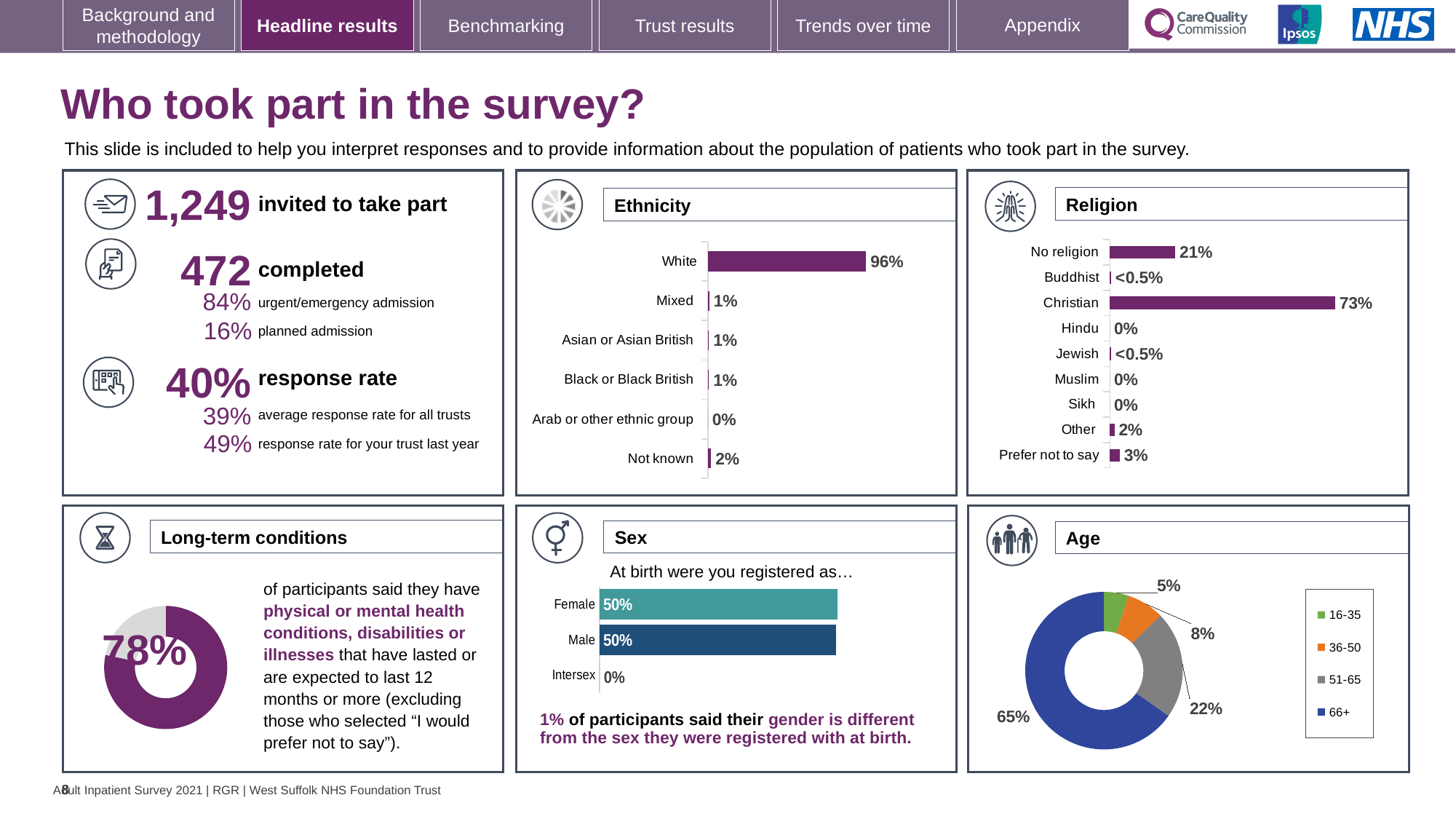
In the Age chart, how many age groups does the legend list? 4 In the Religion chart, what is the difference between the Christian and No religion values? 52% What kind of chart is used for the Age breakdown? Donut chart In the Religion chart, what percentage of participants were Christian? 73% In the Ethnicity chart, what is the value for Not known? 2% In the Ethnicity chart, what percentage of participants were White? 96% In the Ethnicity chart, how many ethnic group categories are shown? 6 In the Ethnicity chart, which ethnic group has the highest value? White In the Sex chart, what percentage of participants were registered as Female at birth? 50% In the Age chart, what share of participants were aged 66+? 65% In the Religion chart, which is larger, Other or Prefer not to say? Prefer not to say In the Religion chart, how many religion categories are listed? 9